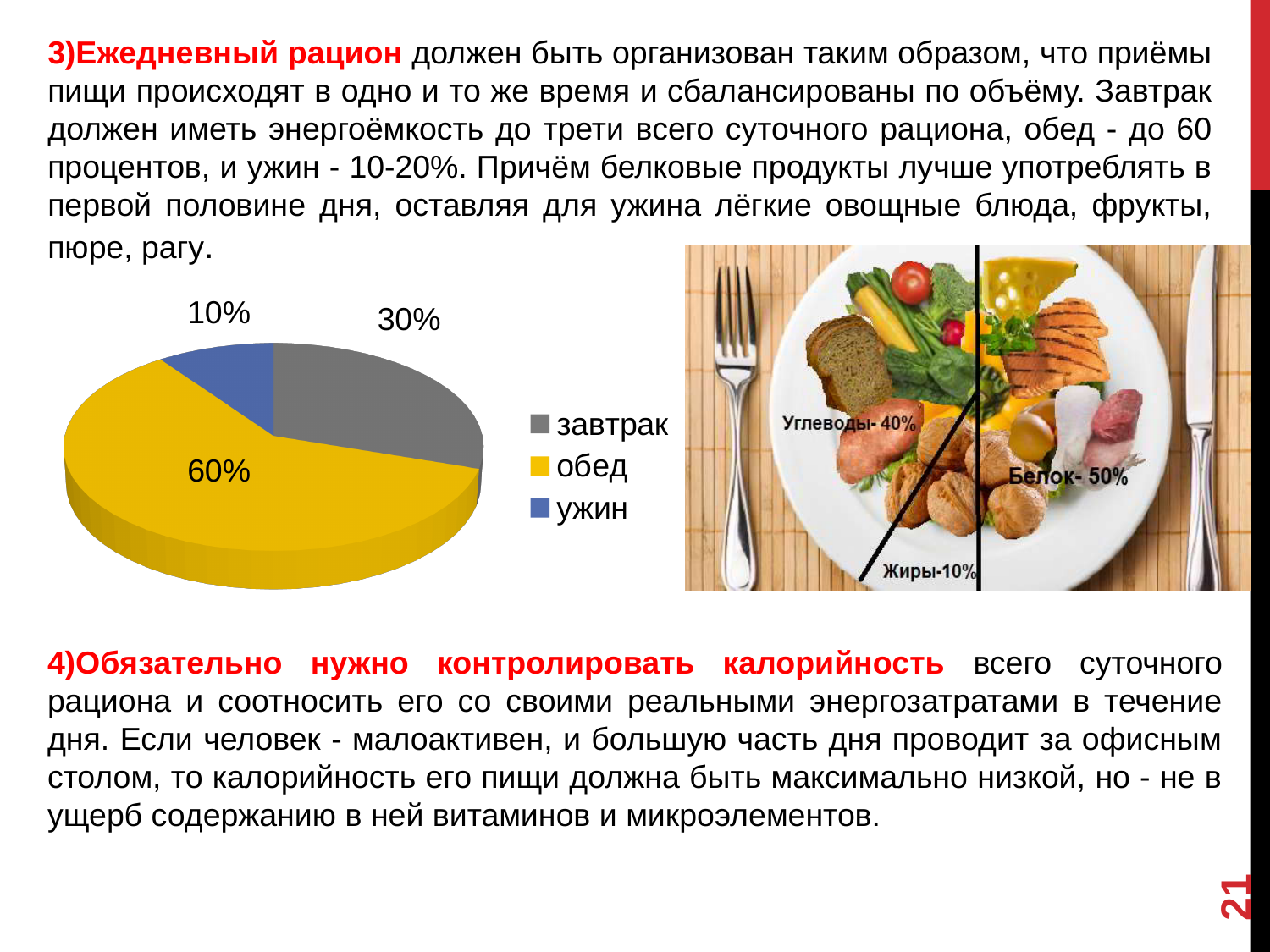
What share of the pie does ужин take? 10% How many slices does the pie chart have? 3 What colour is the slice for обед in the pie chart? yellow What share of the pie does обед take? 60% How many entries does the legend of the pie chart list? 3 What kind of chart is shown on the slide? pie chart What is the difference between the shares of обед and завтрак? 30% What is the difference between the shares of завтрак and ужин? 20% Which is larger, the share of завтрак or the share of ужин? завтрак What share of the pie does завтрак take? 30% Which category has the largest slice of the pie? обед Which category has the smallest slice of the pie? ужин